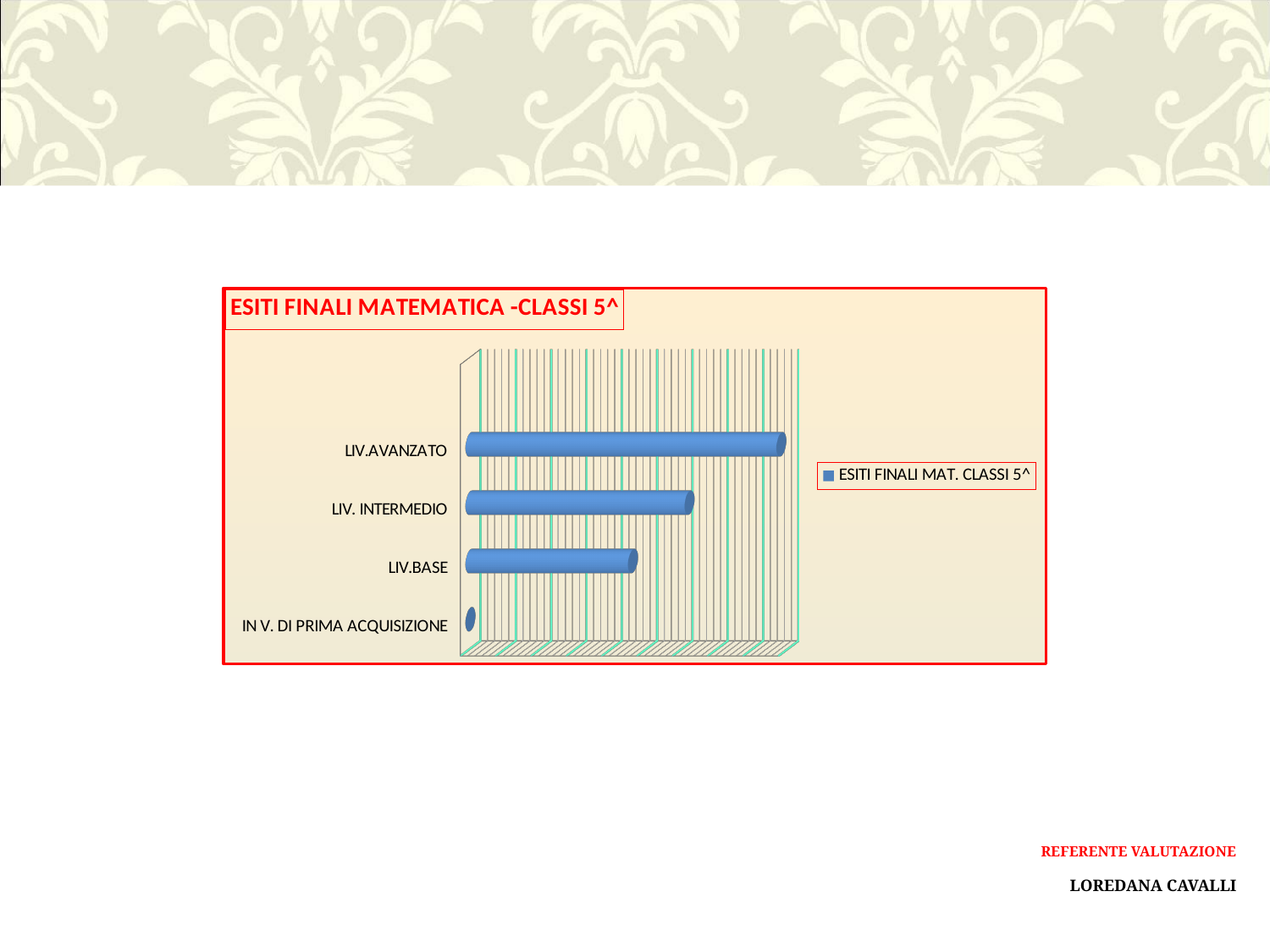
Which category has the second-highest value? LIV. INTERMEDIO Which is larger, the value for LIV.AVANZATO or the value for LIV. INTERMEDIO? LIV.AVANZATO What is the title of the chart? ESITI FINALI MATEMATICA -CLASSI 5^ How many categories are shown on the chart? 4 What kind of chart is shown on the slide? bar chart Which is larger, the value for LIV.BASE or the value for IN V. DI PRIMA ACQUISIZIONE? LIV.BASE What is the name of the series listed in the legend? ESITI FINALI MAT. CLASSI 5^ Which is larger, the value for LIV. INTERMEDIO or the value for LIV.BASE? LIV. INTERMEDIO Which category has the lowest value? IN V. DI PRIMA ACQUISIZIONE How many series does the legend list? 1 Which category has the highest value? LIV.AVANZATO